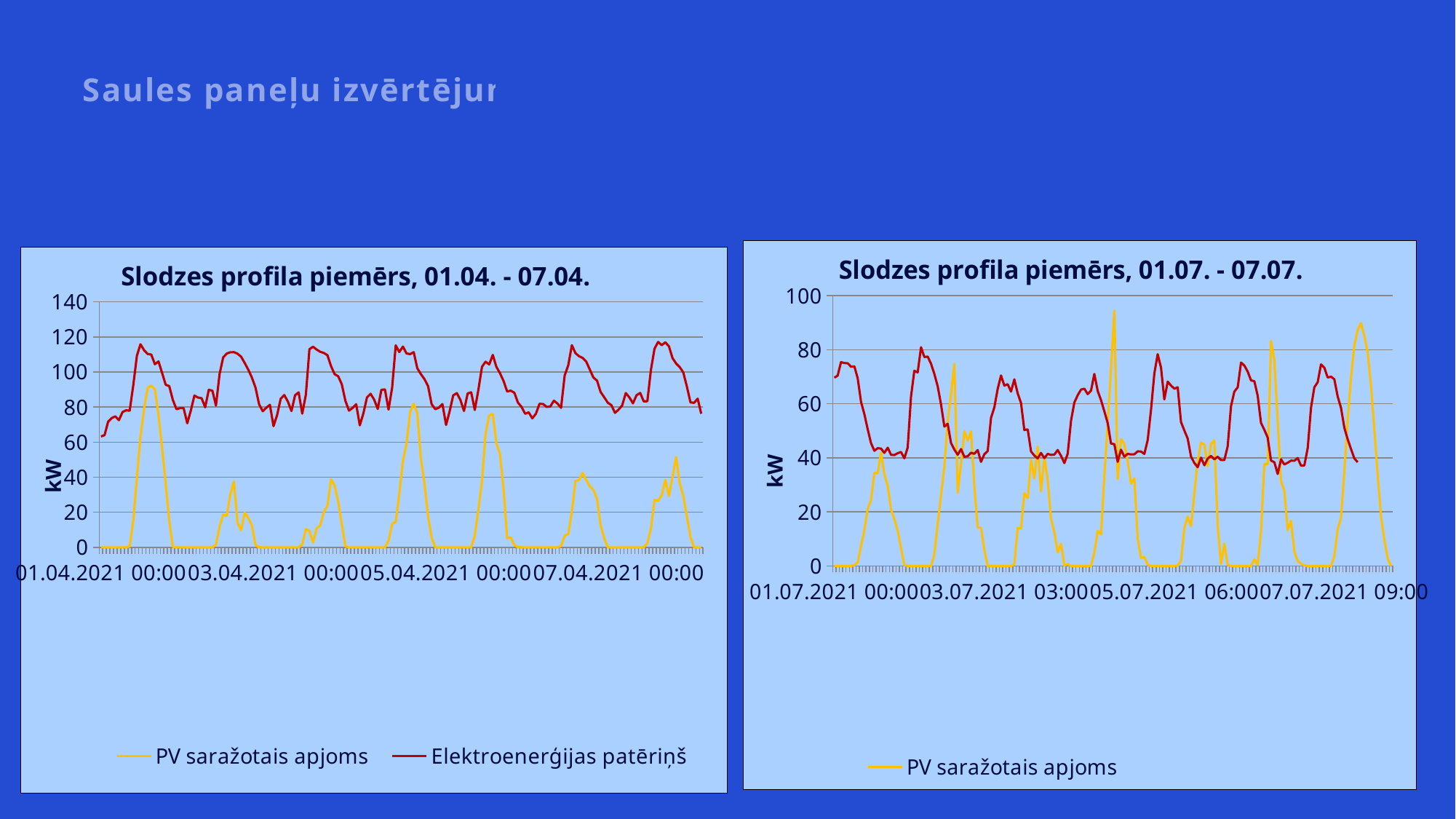
In the left chart (01.04. - 07.04.), is the lowest value of 'Elektroenerģijas patēriņš' greater or less than 40? greater What kind of chart is the left chart titled 'Slodzes profila piemērs, 01.04. - 07.04.'? line chart What is the y-axis label of the right chart (01.07. - 07.07.)? kW What kind of chart is the right chart titled 'Slodzes profila piemērs, 01.07. - 07.07.'? line chart In the right chart (01.07. - 07.07.), is the highest value of 'PV saražotais apjoms' greater or less than 80? greater How many series does the legend of the left chart (01.04. - 07.04.) list? 2 In the left chart (01.04. - 07.04.), which series is drawn in red? Elektroenerģijas patēriņš How many series does the legend of the right chart (01.07. - 07.07.) list? 1 In the left chart (01.04. - 07.04.), is the highest value of 'PV saražotais apjoms' greater or less than 100? less In the left chart (01.04. - 07.04.), which series reaches higher values overall, 'PV saražotais apjoms' or 'Elektroenerģijas patēriņš'? Elektroenerģijas patēriņš